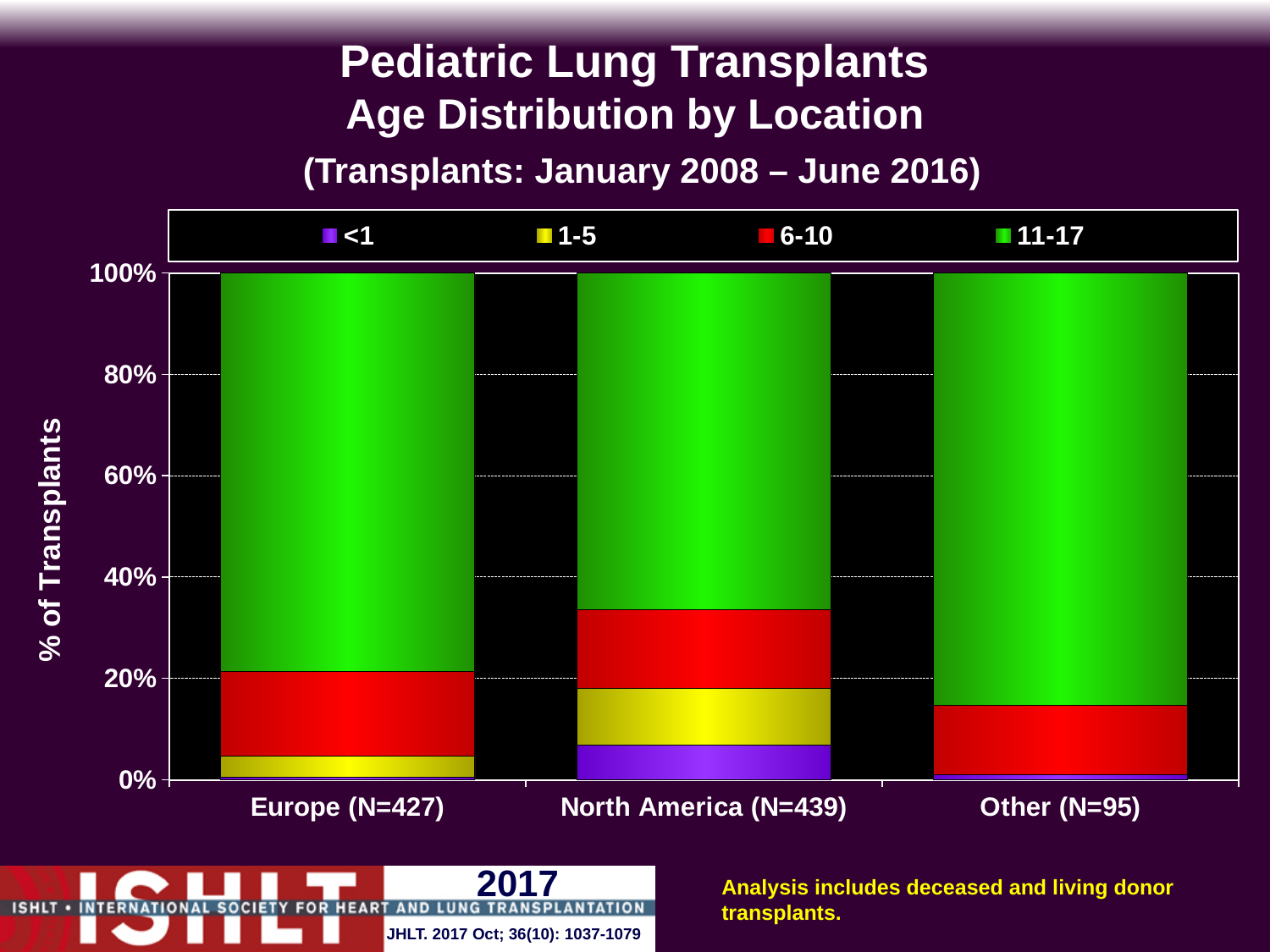
Which is larger, the 11-17 share for Other (N=95) or for North America (N=439)? Other (N=95) What is the label of the y axis? % of Transplants Is the 1-5 share for North America (N=439) greater or less than 20%? less Which location has the largest 1-5 share? North America (N=439) How many location categories are shown on the x axis? 3 What kind of chart is shown on the slide? stacked bar chart How many age-group series does the legend list? 4 Which location has the largest 11-17 share? Other (N=95) Which location has the smallest 11-17 share? North America (N=439) Is the 11-17 share for Europe (N=427) greater or less than 60%? greater Is the 11-17 share for North America (N=439) greater or less than 80%? less Which location has the largest <1 share? North America (N=439)